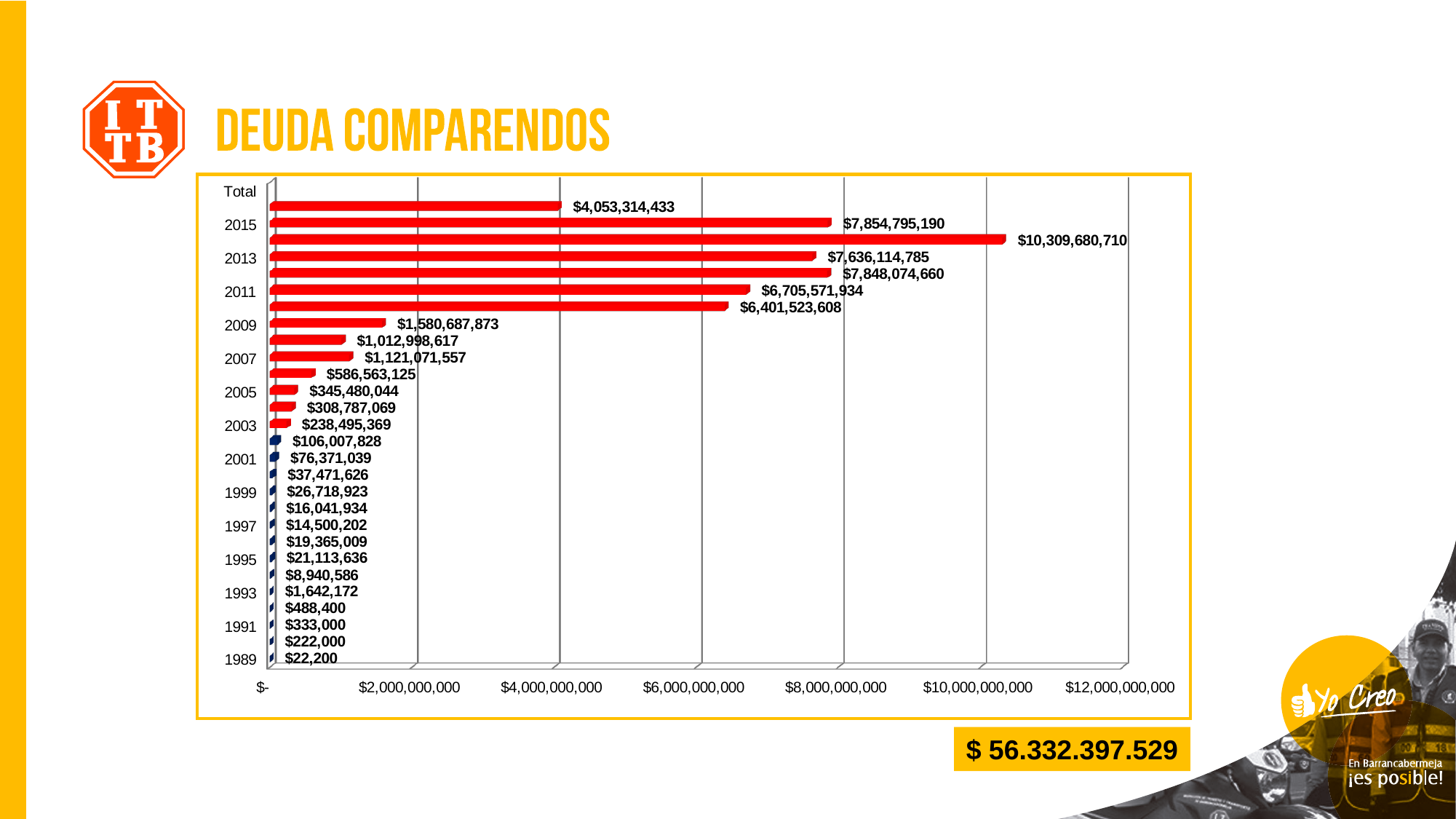
What is the value for 2011? $6,705,571,934 What is the value for 1989? $22,200 What is the title of the chart? DEUDA COMPARENDOS Is the value for 2011 greater or less than $6,000,000,000? greater What is the largest value shown by any bar in the chart? $10,309,680,710 What kind of chart is shown on the slide? Bar chart What is the value for 2013? $7,636,114,785 What is the value for 2015? $7,854,795,190 What is the difference between the values for 2015 and 2013? $218,680,405 Which is larger, the value for 2011 or the value for 2009? 2011 What total amount is shown in the yellow box below the chart? $ 56.332.397.529 Which labeled year has the lowest value? 1989